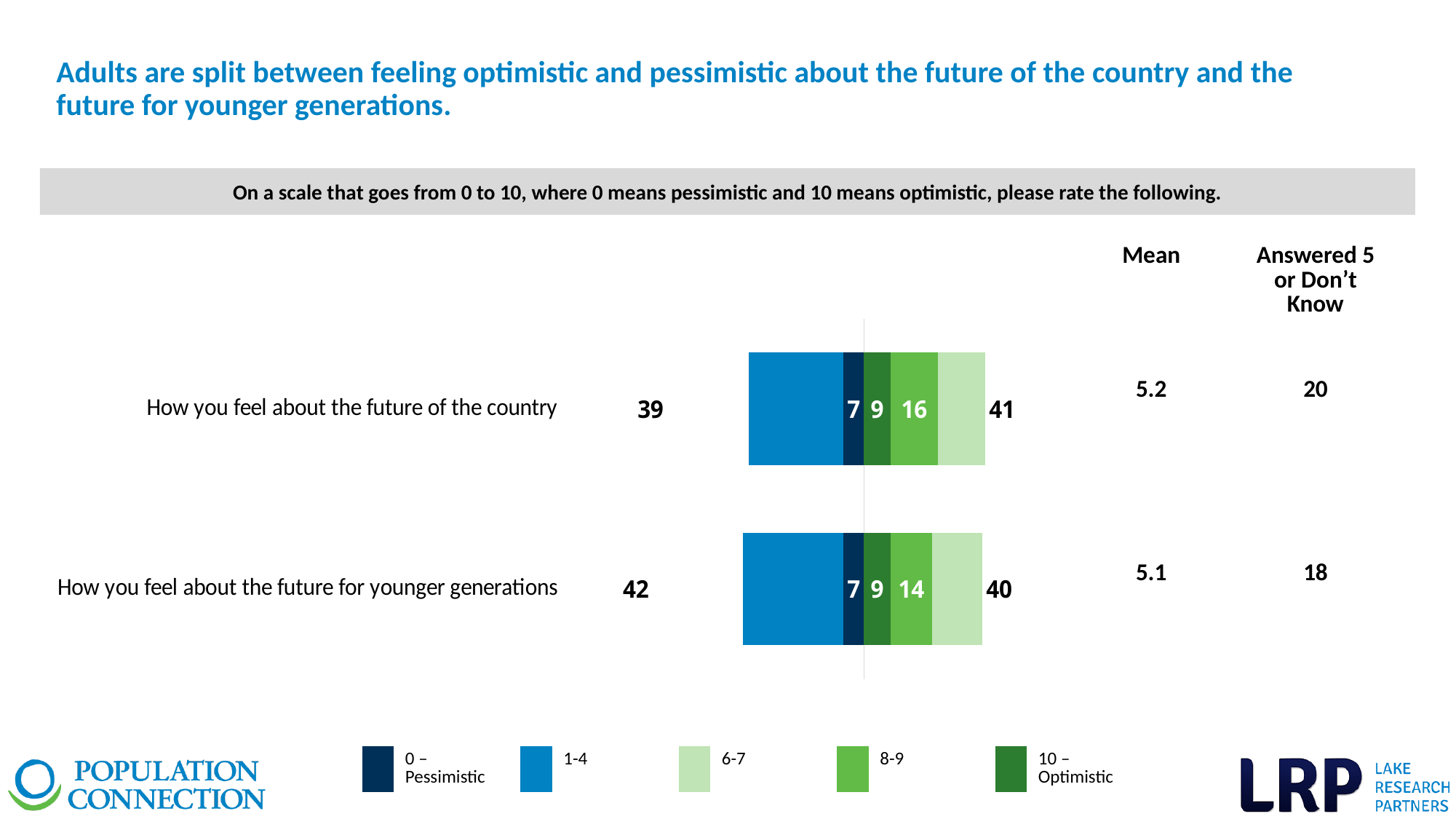
What kind of chart is shown on the slide? bar chart How many entries does the legend list? 5 Which legend entry is shown in the darkest navy colour? 0 – Pessimistic What is the total pessimistic value (left-side label) for 'How you feel about the future of the country'? 39 Which item has the higher total pessimistic value: the future of the country or the future for younger generations? How you feel about the future for younger generations What is the value of the '8-9' segment for 'How you feel about the future for younger generations'? 14 What is the Mean for 'How you feel about the future of the country'? 5.2 What is the total optimistic value (right-side label) for 'How you feel about the future for younger generations'? 40 What is the 'Answered 5 or Don't Know' value for 'How you feel about the future for younger generations'? 18 What is the difference between the '8-9' segment values for the future of the country and the future for younger generations? 2 What is the value of the '8-9' segment for 'How you feel about the future of the country'? 16 How many categories (survey items) does the chart show? 2